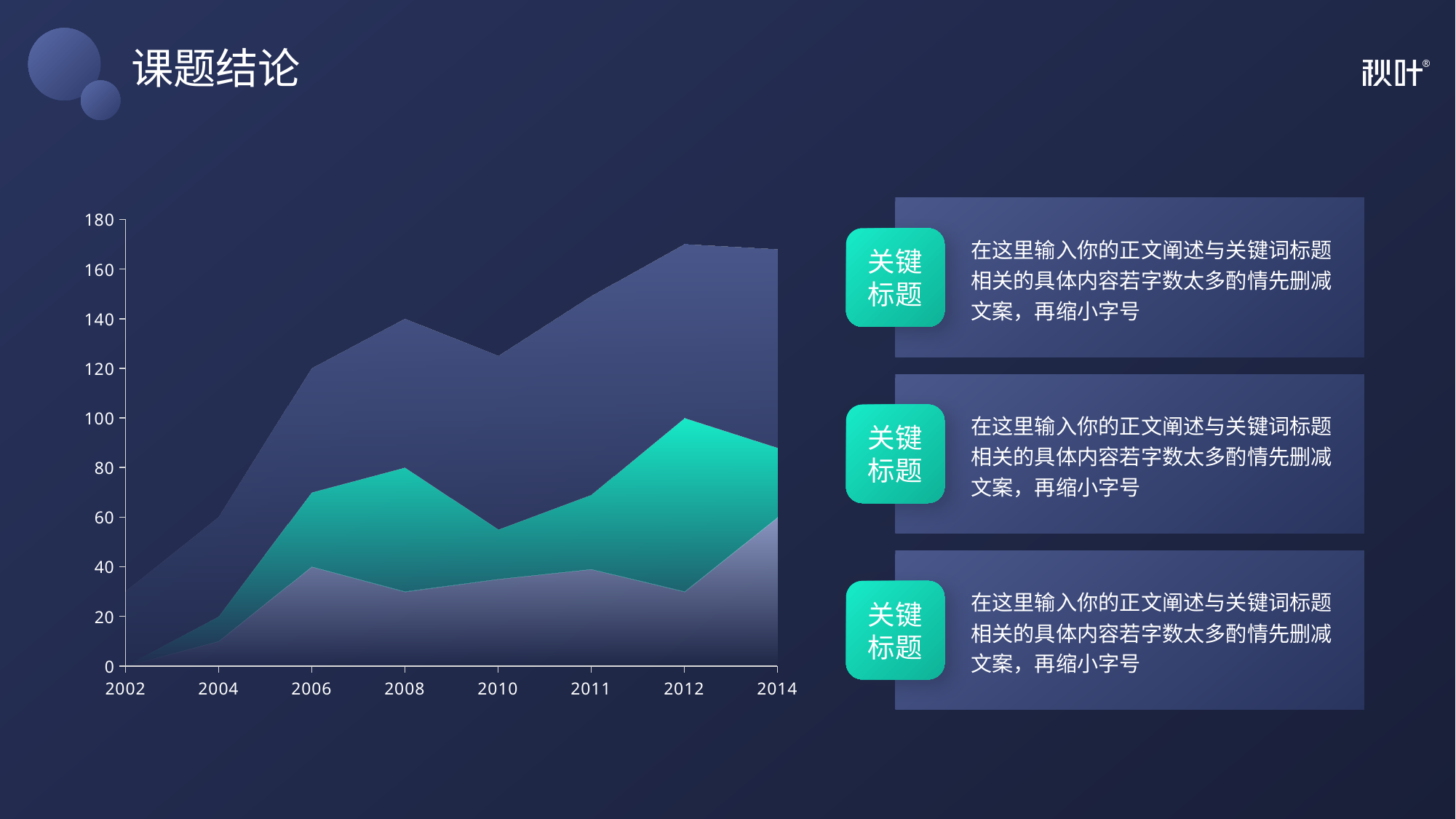
Is the value of the bottom (light purple) series in 2004 greater or less than 20? less What is the highest value shown on the y axis of the chart? 180 Is the value of the top (dark blue) series in 2012 greater or less than 160? greater How many shaded series (areas) are plotted in the chart? 3 In which year does the middle (teal) series reach its highest value? 2012 Is the value of the middle (teal) series in 2012 greater or less than 80? greater What kind of chart is shown on the slide? Area chart Does the top (dark blue) series rise or fall from 2002 to 2006? rise For the top (dark blue) series, which year has the larger value, 2008 or 2010? 2008 How many years are labelled on the x axis of the chart? 8 What is the first year shown on the x axis of the chart? 2002 In which year does the top (dark blue) series reach its highest value? 2012